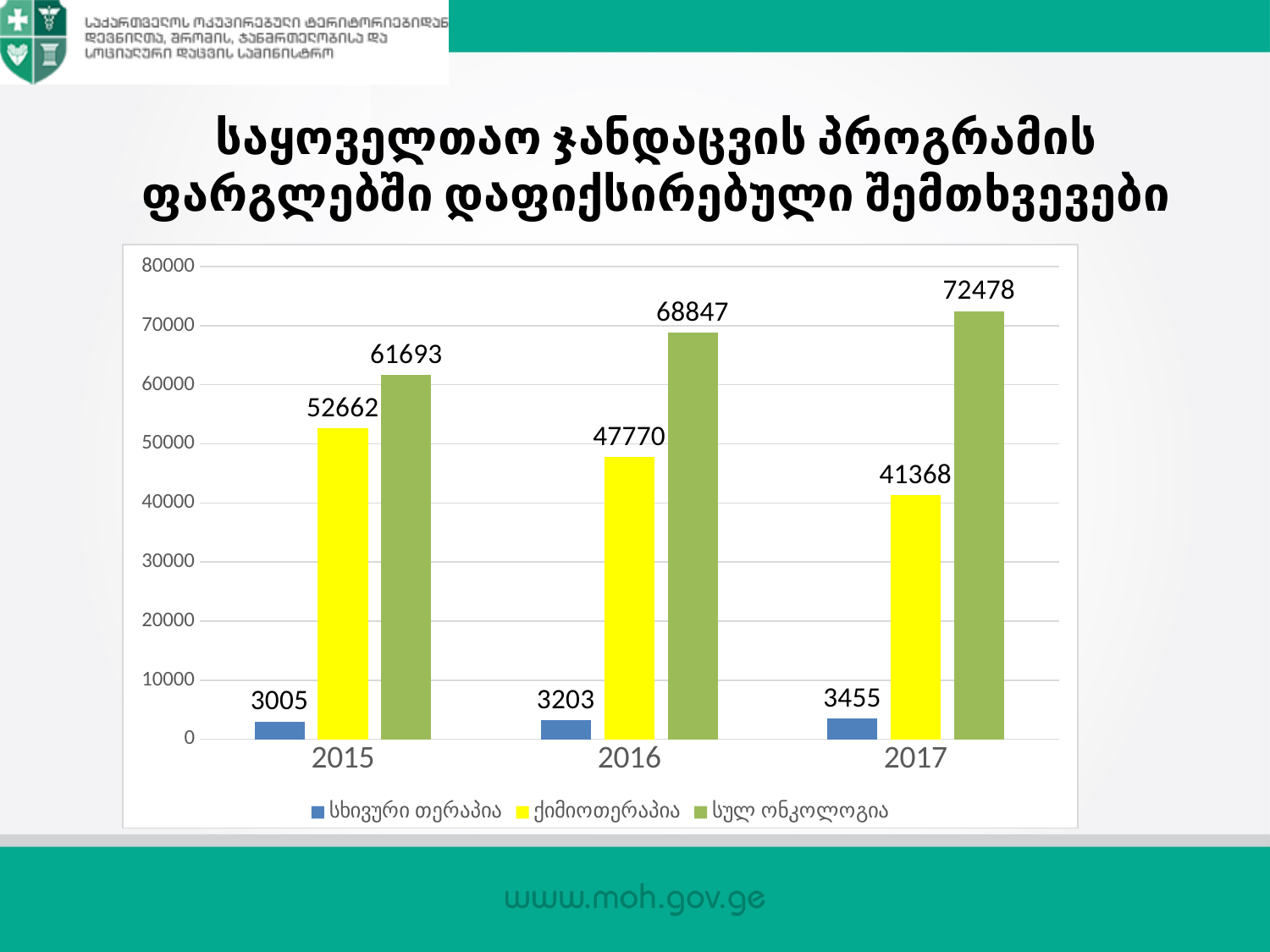
What is the value for სხივური თერაპია in 2015? 3005 What is the value for ქიმიოთერაპია in 2017? 41368 Which is larger: ქიმიოთერაპია in 2015 or ქიმიოთერაპია in 2016? ქიმიოთერაპია in 2015 How many series does the legend list? 3 Do the values for ქიმიოთერაპია rise or fall from 2015 to 2017? Fall What is the value for ქიმიოთერაპია in 2016? 47770 In which year is the value for ქიმიოთერაპია lowest? 2017 How many years are shown on the x axis? 3 What is the value for სულ ონკოლოგია in 2017? 72478 What is the difference between the სულ ონკოლოგია values for 2017 and 2015? 10785 What kind of chart is shown on the slide? Bar chart In which year is the value for სულ ონკოლოგია highest? 2017